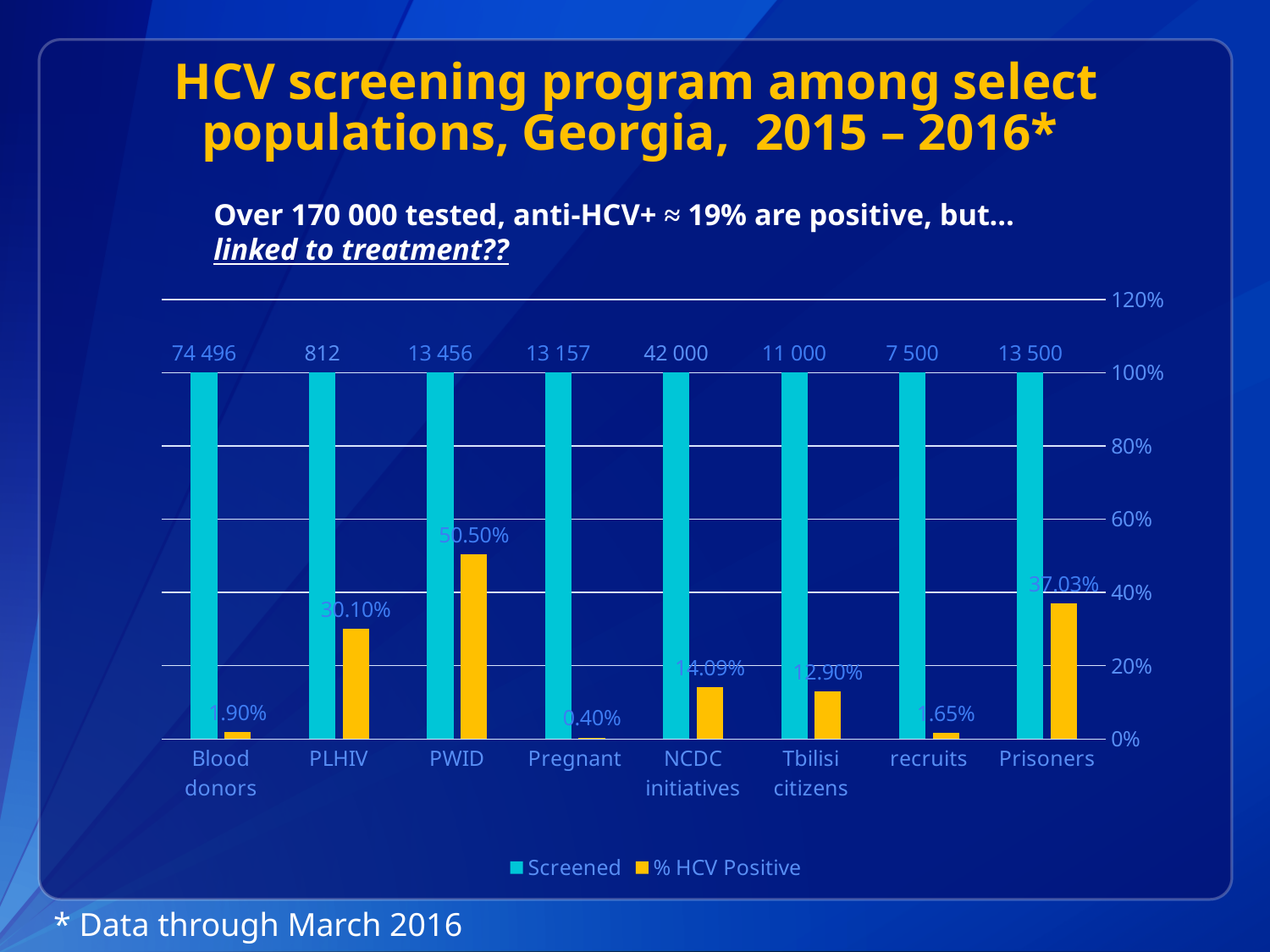
Which has a higher % HCV Positive, PLHIV or Prisoners? Prisoners What is the Screened value for Blood donors? 74 496 Which population has the highest % HCV Positive? PWID What kind of chart is shown on the slide? bar chart Which population has the smallest number Screened? PLHIV Which population has the lowest % HCV Positive? Pregnant How many series does the legend list? 2 What is the difference in % HCV Positive between PWID and Prisoners? 13.47% Is the % HCV Positive value for NCDC initiatives greater or less than 20%? less What is the Screened value for NCDC initiatives? 42 000 How many populations are shown on the x axis? 8 What is the % HCV Positive value for PWID? 50.50%